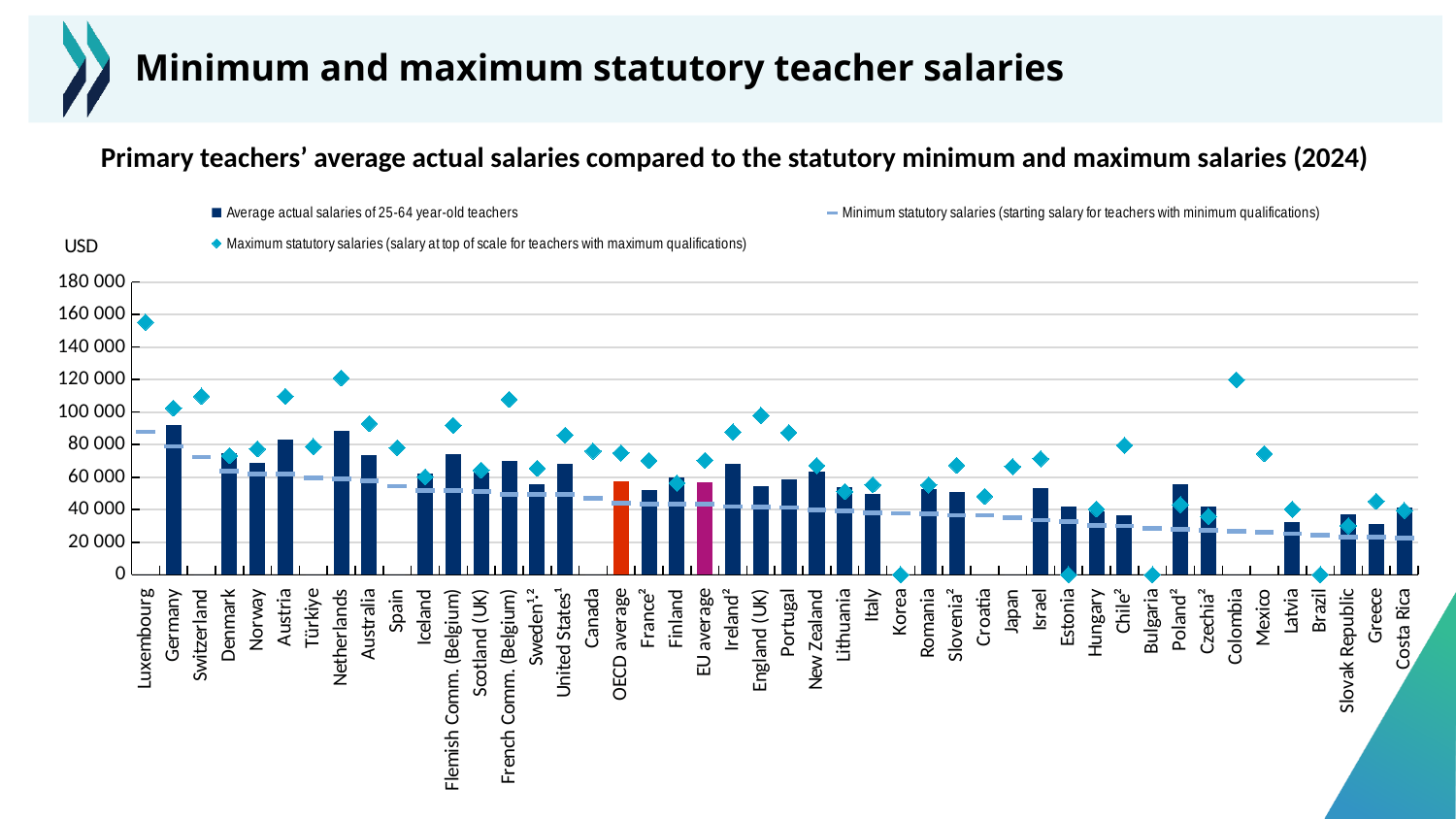
Is the maximum statutory salary for Luxembourg greater or less than 140 000? greater Which country has the highest maximum statutory salary (diamond marker)? Luxembourg What unit is shown on the vertical axis? USD Which country has the tallest bar for average actual salaries of 25-64 year-old teachers? Germany How many series does the legend list? 3 Do the minimum statutory salaries generally rise or fall moving from left to right along the x axis? fall Is the average actual salary bar for Greece greater or less than 40 000? less Is the average actual salary bar for Germany greater or less than 80 000? greater Which has the larger average actual salary bar, Germany or Denmark? Germany Which year does the chart subtitle refer to? 2024 What kind of chart is shown on the slide? bar chart